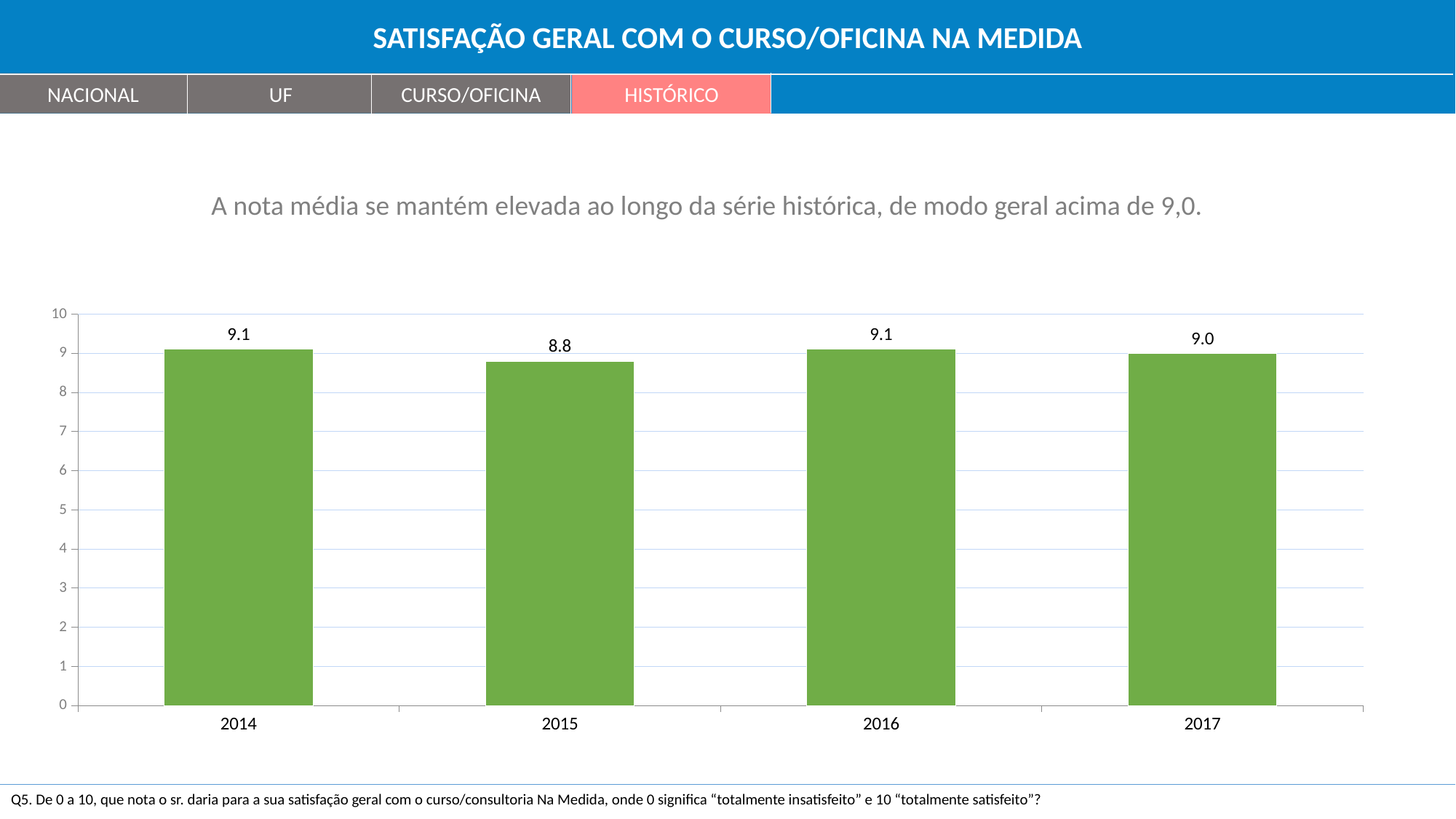
Does the value rise or fall from 2015 to 2016? rise Which year has the lowest value? 2015 What is the value for 2015? 8.8 Which is larger, the value for 2015 or the value for 2017? 2017 What is the difference between the values for 2016 and 2017? 0.1 What is the value for 2017? 9.0 What kind of chart is shown on the slide? bar chart What is the difference between the values for 2014 and 2015? 0.3 How many years are shown on the x axis? 4 What colour are the bars in the chart? green Is the value for 2015 greater or less than 9? less What is the value for 2014? 9.1